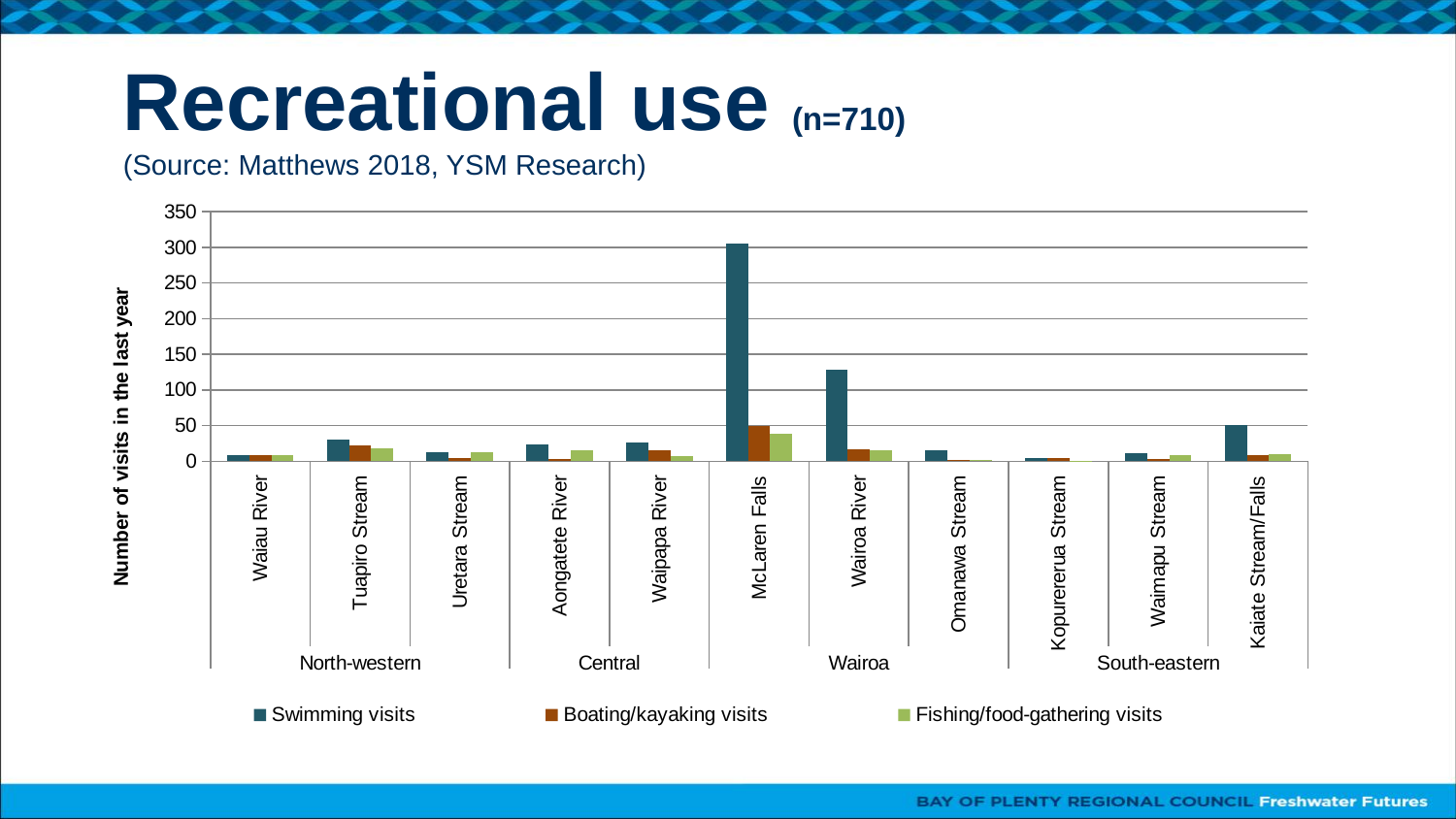
How many rivers/streams are shown along the x axis? 11 How many series does the legend list? 3 Is the number of swimming visits for McLaren Falls greater or less than 250? greater How many regional groups (e.g. North-western, Central) are shown along the x axis? 4 Which site has the highest number of fishing/food-gathering visits? McLaren Falls What kind of chart is shown on the slide? bar chart Is the number of fishing/food-gathering visits for McLaren Falls greater or less than 50? less Which site has the highest number of boating/kayaking visits? McLaren Falls Which site has the highest number of swimming visits? McLaren Falls Which has more swimming visits, Wairoa River or Kaiate Stream/Falls? Wairoa River What is the label of the y axis? Number of visits in the last year Is the number of swimming visits for Wairoa River greater or less than 100? greater